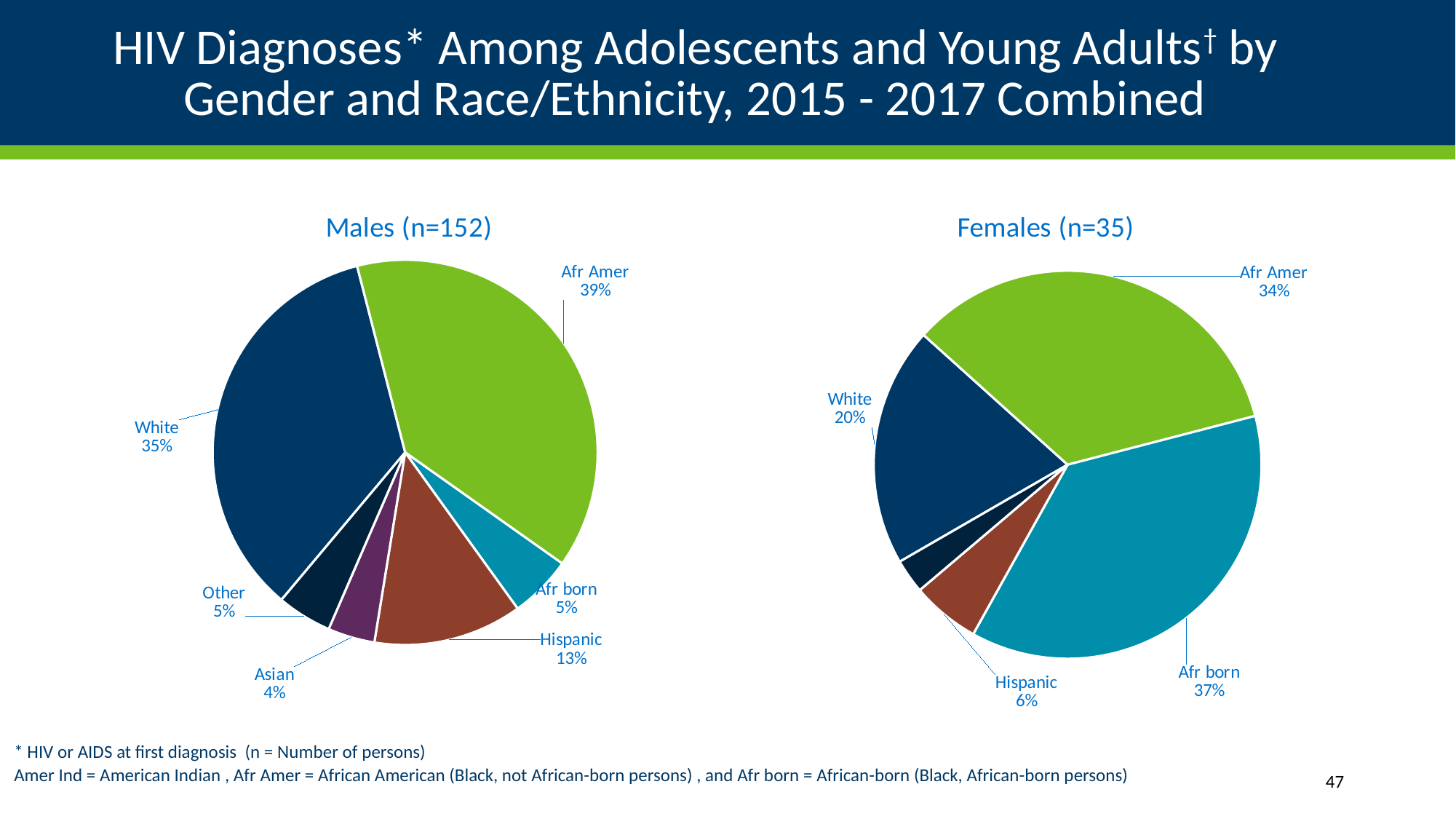
In the Males (n=152) chart, what is the difference in percentage points between the Afr Amer and White slices? 4% In the Males (n=152) chart, which race/ethnicity group has the largest slice? Afr Amer What type of chart is used on this slide? Pie chart In the Males (n=152) chart, which race/ethnicity group has the smallest slice? Asian In the Females (n=35) chart, what is the difference in percentage points between the Afr born and White slices? 17% In the Males (n=152) chart, what percentage is Hispanic? 13% How many labeled race/ethnicity categories are shown in the Males (n=152) chart? 6 In the Females (n=35) chart, what share of HIV diagnoses is Afr born? 37% In the Females (n=35) chart, which race/ethnicity group has the largest slice? Afr born Is the Hispanic share larger in the Males (n=152) chart or the Females (n=35) chart? Males (n=152) In the Females (n=35) chart, what percentage is White? 20% In the Males (n=152) chart, what share of HIV diagnoses is Afr Amer? 39%